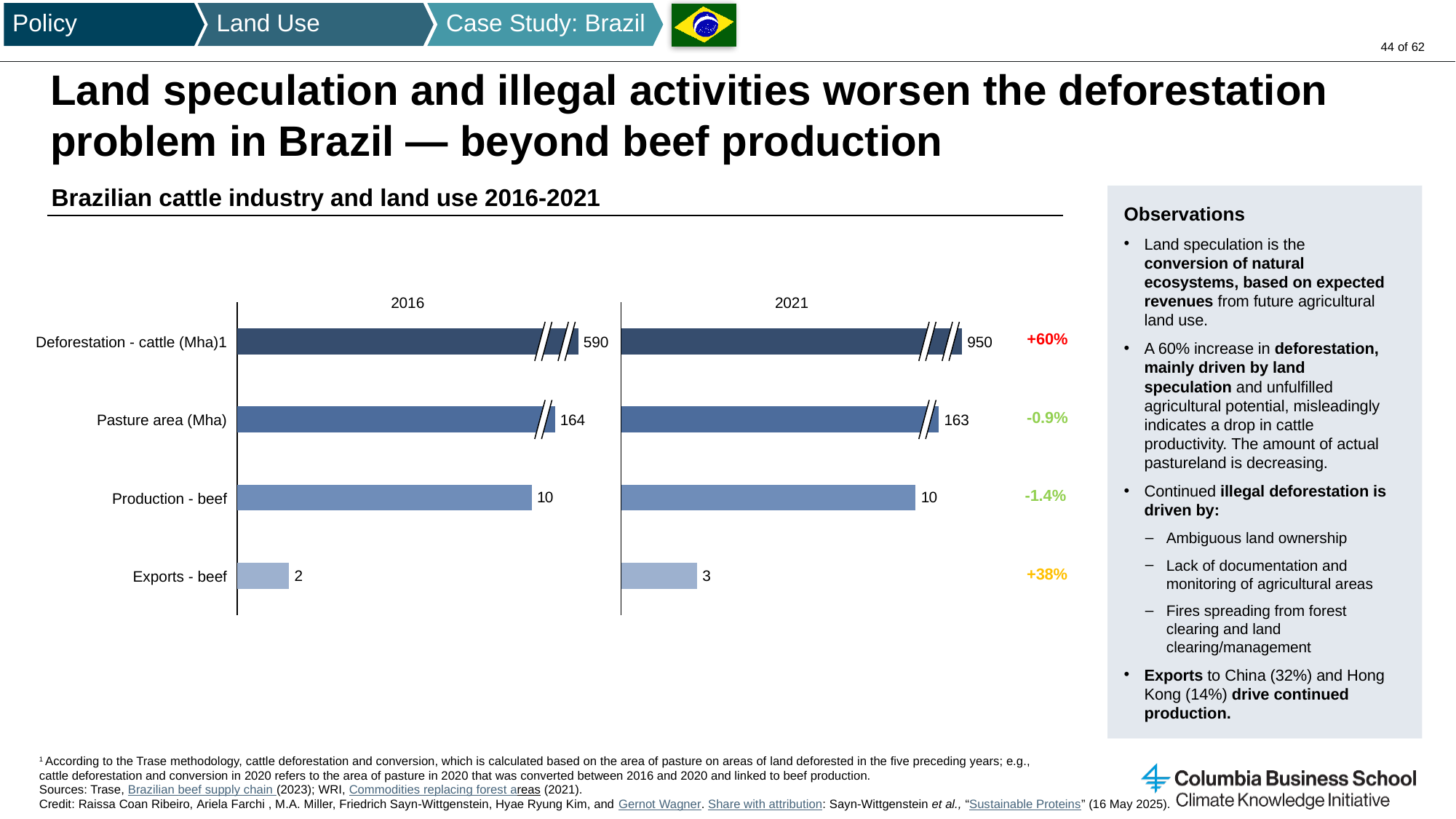
How many categories are plotted in the chart? 4 Which category has the highest value in the 2021 panel? Deforestation - cattle (Mha) Is the Pasture area (Mha) value larger in 2016 or in 2021? 2016 What type of chart is used to show the Brazilian cattle industry and land use data? Bar chart What is the difference between the Deforestation - cattle values for 2021 and 2016? 360 What percentage change is shown next to the Deforestation - cattle row? +60% What is the value for Deforestation - cattle (Mha) in 2021? 950 What is the Pasture area (Mha) value shown for 2021? 163 What is the Exports - beef value shown for 2016? 2 Which category has the lowest value in the 2016 panel? Exports - beef What is the value for Deforestation - cattle (Mha) in 2016? 590 What percentage change is shown for Exports - beef? +38%